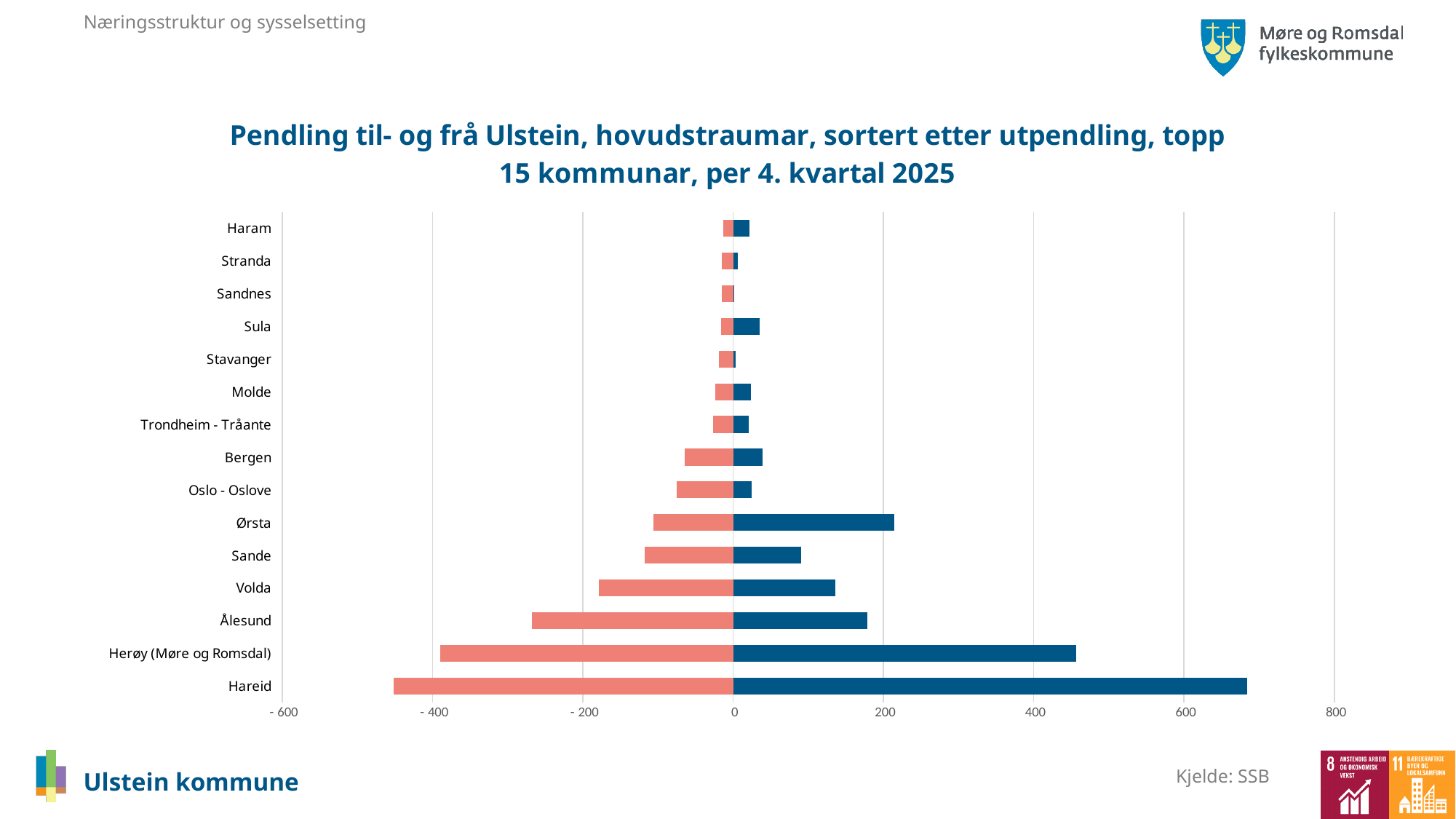
Which has the larger blue (positive) bar, Ørsta or Sande? Ørsta How many municipalities (categories) are listed on the chart? 15 What kind of chart is shown on the slide? bar chart Which has the longer red (negative) bar, Ålesund or Volda? Ålesund Is the red (negative) value for Ålesund greater or less than -200? less Which municipality has the longest red (negative) bar? Hareid Is the blue (positive) value for Hareid greater or less than 600? greater Which municipality has the longest blue (positive) bar? Hareid Is the blue (positive) value for Herøy (Møre og Romsdal) greater or less than 400? greater Which municipality is listed at the top of the chart? Haram